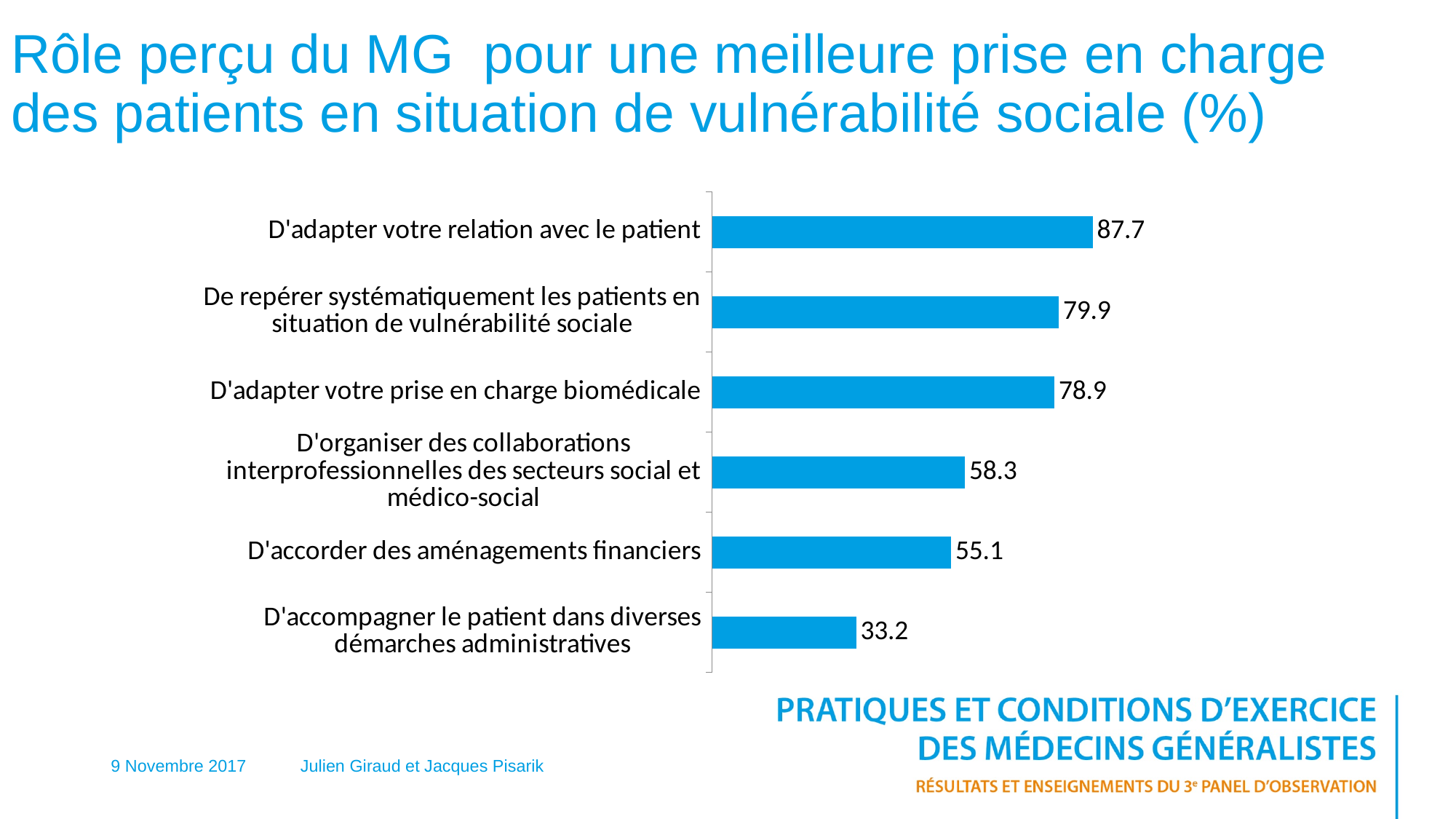
Which is larger: the value for "D'organiser des collaborations interprofessionnelles des secteurs social et médico-social" or for "D'accorder des aménagements financiers"? D'organiser des collaborations interprofessionnelles des secteurs social et médico-social Which category has the highest value? D'adapter votre relation avec le patient How many categories are shown in the chart? 6 What is the value for "D'organiser des collaborations interprofessionnelles des secteurs social et médico-social"? 58.3 What colour are the bars in the chart? Blue What is the value for "D'accorder des aménagements financiers"? 55.1 What is the difference between the values for "D'adapter votre relation avec le patient" and "D'accompagner le patient dans diverses démarches administratives"? 54.5 What is the value for "D'adapter votre relation avec le patient"? 87.7 What is the difference between the values for "De repérer systématiquement les patients en situation de vulnérabilité sociale" and "D'adapter votre prise en charge biomédicale"? 1.0 What is the value for "D'accompagner le patient dans diverses démarches administratives"? 33.2 Which category has the lowest value? D'accompagner le patient dans diverses démarches administratives What kind of chart is shown on the slide? Bar chart